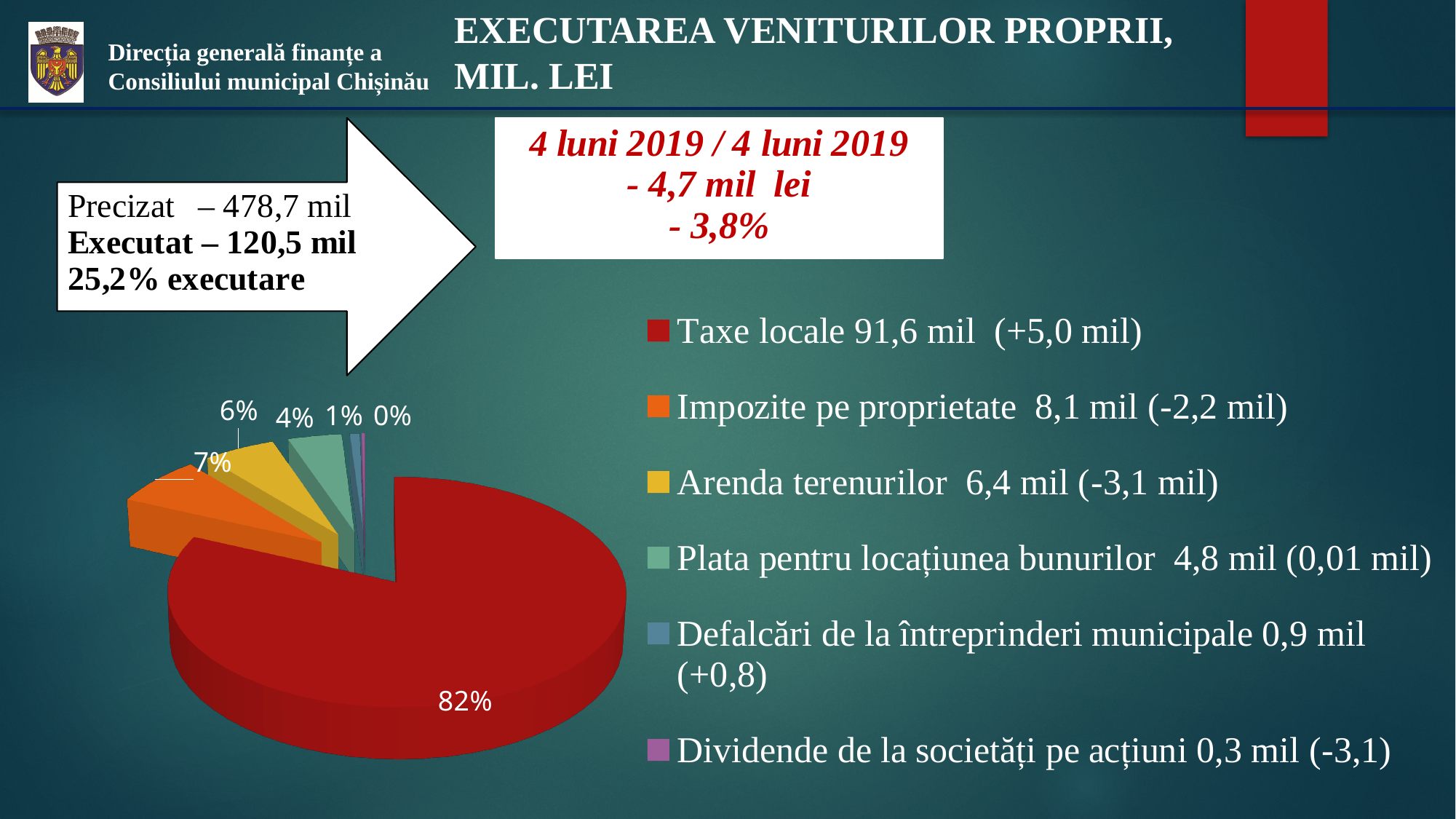
What is the difference in percentage points between the Taxe locale slice and the Impozite pe proprietate slice? 75 percentage points Which category has the smallest slice of the pie? Dividende de la societăți pe acțiuni How many slices does the pie chart have? 6 What share of the pie does Impozite pe proprietate represent? 7% How many entries does the legend list? 6 What share of the pie does Taxe locale represent? 82% What share of the pie does Arenda terenurilor represent? 6% What kind of chart is shown on the slide? Pie chart Which category has the largest slice of the pie? Taxe locale Which slice is larger, Arenda terenurilor or Plata pentru locațiunea bunurilor? Arenda terenurilor